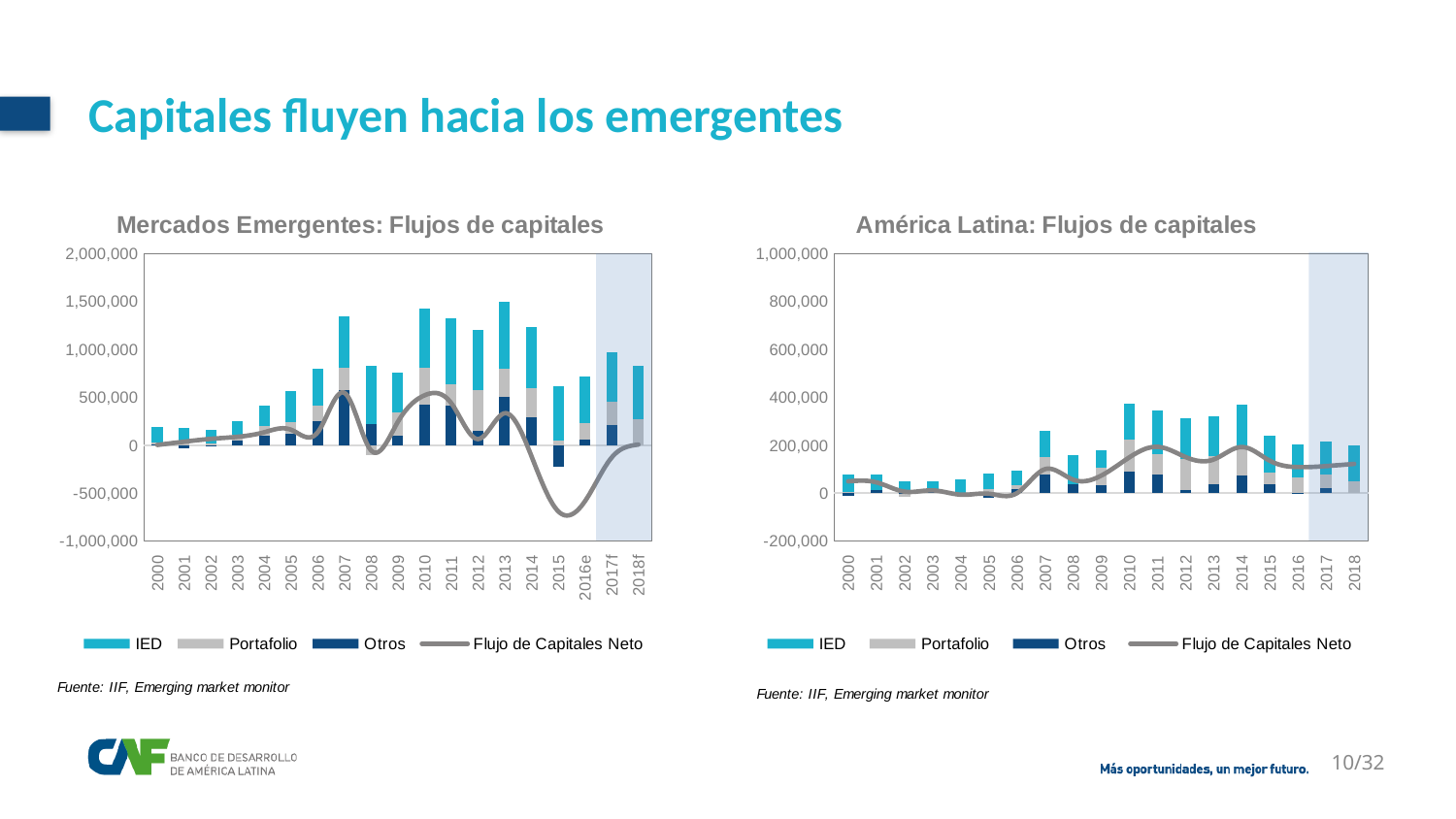
What kind of chart is the 'Mercados Emergentes: Flujos de capitales' chart? A stacked bar chart with a line In the 'Mercados Emergentes: Flujos de capitales' chart, is the total stacked bar for 2000 greater or less than 500,000? less In the 'Mercados Emergentes: Flujos de capitales' chart, which year has the lowest value of the Flujo de Capitales Neto line? 2015 In the 'Mercados Emergentes: Flujos de capitales' chart, which year has the taller total stacked bar, 2007 or 2008? 2007 In the 'Mercados Emergentes: Flujos de capitales' chart, is the total stacked bar for 2010 greater or less than 1,000,000? greater Which series is shown as a line rather than bars in the 'América Latina: Flujos de capitales' chart? Flujo de Capitales Neto In the 'Mercados Emergentes: Flujos de capitales' chart, is the Flujo de Capitales Neto line in 2015 greater or less than -500,000? less How many years are shown on the x axis of the 'Mercados Emergentes: Flujos de capitales' chart? 19 In the 'Mercados Emergentes: Flujos de capitales' chart, does the Flujo de Capitales Neto line rise or fall from 2013 to 2015? Fall How many series does the legend of the 'América Latina: Flujos de capitales' chart list? 4